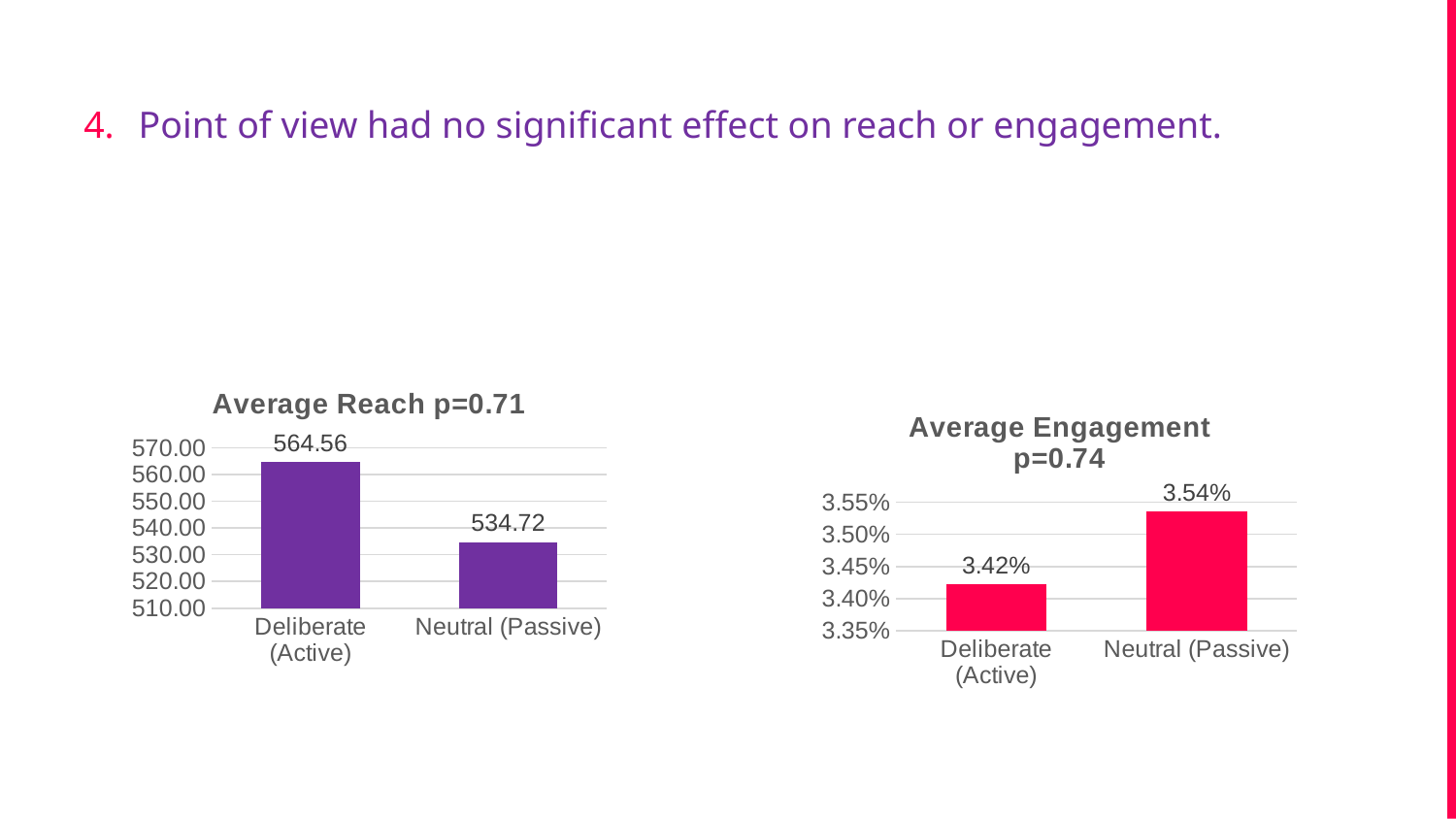
In the Average Reach p=0.71 chart, what is the difference between Deliberate (Active) and Neutral (Passive)? 29.84 In the Average Reach p=0.71 chart, which category has the highest value? Deliberate (Active) In the Average Engagement p=0.74 chart, which category has the lowest value? Deliberate (Active) In the Average Reach p=0.71 chart, what is the value for Deliberate (Active)? 564.56 In the Average Engagement p=0.74 chart, what is the difference between Neutral (Passive) and Deliberate (Active)? 0.12% In the Average Reach p=0.71 chart, is the value for Neutral (Passive) greater or less than 540.00? less In the Average Reach p=0.71 chart, what is the value for Neutral (Passive)? 534.72 How many categories does the Average Reach p=0.71 chart show? 2 In the Average Engagement p=0.74 chart, what is the value for Deliberate (Active)? 3.42% In the Average Engagement p=0.74 chart, what is the value for Neutral (Passive)? 3.54% In the Average Engagement p=0.74 chart, which is larger: Deliberate (Active) or Neutral (Passive)? Neutral (Passive) What kind of chart is the Average Engagement p=0.74 chart? bar chart